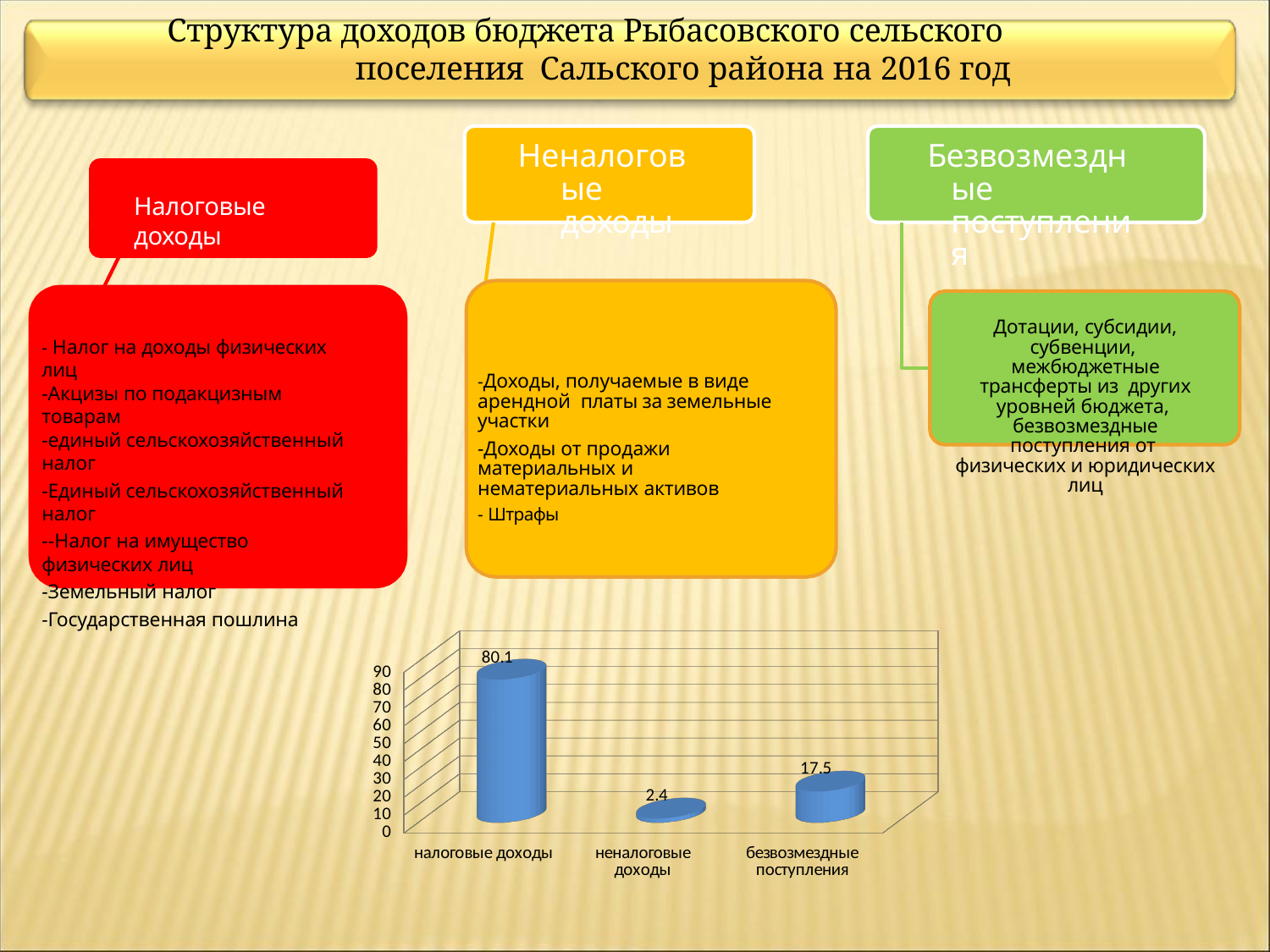
What kind of chart is shown on the slide? bar chart How many categories are shown on the chart? 3 Which category has the lowest value? неналоговые доходы Which is larger, the value for безвозмездные поступления or the value for неналоговые доходы? безвозмездные поступления What is the difference between the values for налоговые доходы and безвозмездные поступления? 62.6 Which category has the highest value? налоговые доходы Is the value for налоговые доходы greater or less than 70? greater What is the value for безвозмездные поступления? 17.5 What is the value for налоговые доходы? 80.1 What is the difference between the values for безвозмездные поступления and неналоговые доходы? 15.1 What is the value for неналоговые доходы? 2.4 Is the value for безвозмездные поступления greater or less than 20? less